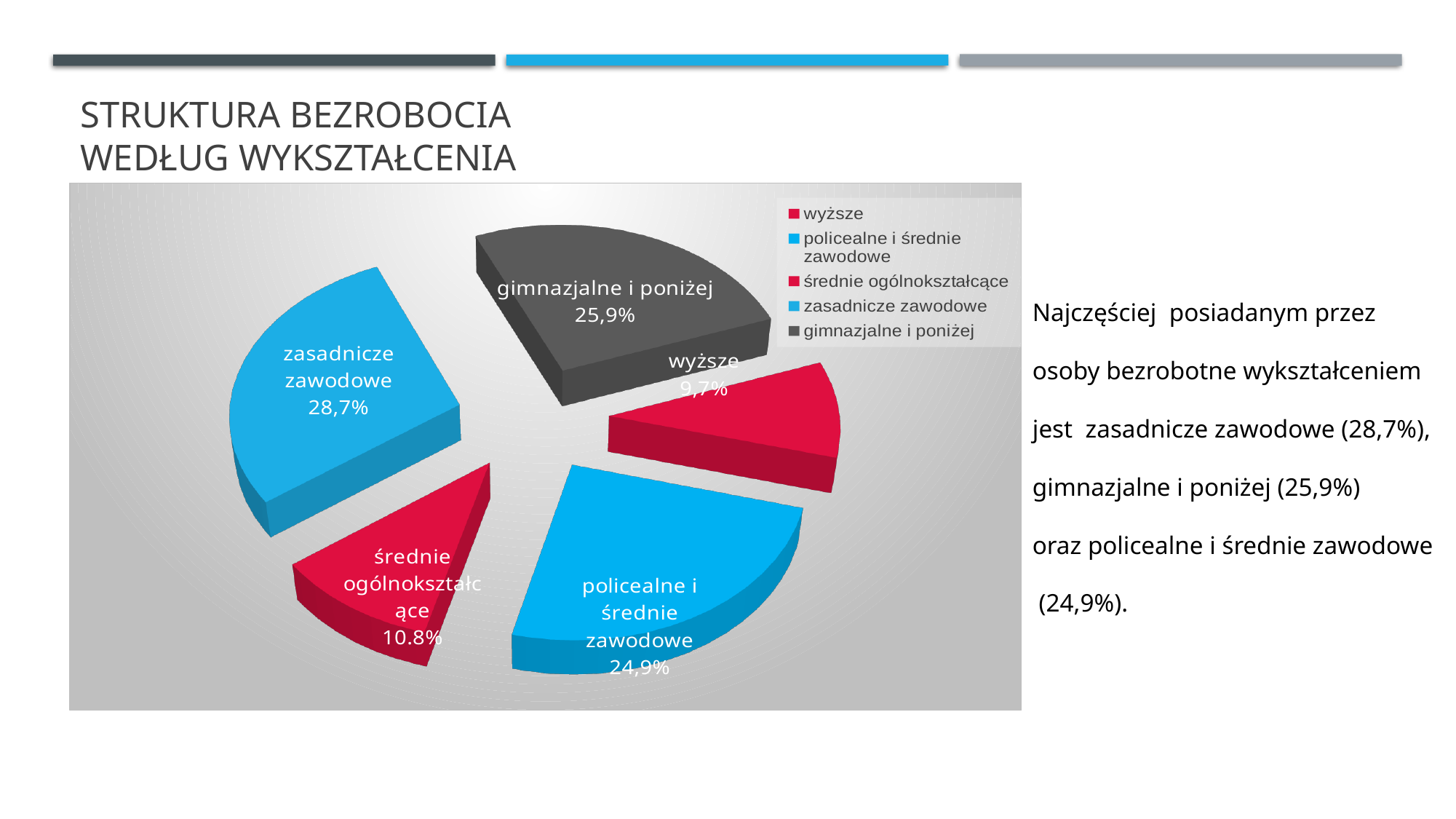
What share of the pie does the "policealne i średnie zawodowe" slice have? 24,9% What share of the pie does the "średnie ogólnokształcące" slice have? 10.8% What share of the pie does the "wyższe" slice have? 9,7% How many slices does the pie chart have? 5 What colour is the "gimnazjalne i poniżej" slice? dark grey Which category has the largest share of the pie? zasadnicze zawodowe What share of the pie does the "gimnazjalne i poniżej" slice have? 25,9% Which is larger, the share for "gimnazjalne i poniżej" or the share for "policealne i średnie zawodowe"? gimnazjalne i poniżej What share of the pie does the "zasadnicze zawodowe" slice have? 28,7% What is the difference in percentage points between the "zasadnicze zawodowe" share and the "wyższe" share? 19 percentage points Which category has the smallest share of the pie? wyższe What kind of chart is shown on the slide? pie chart